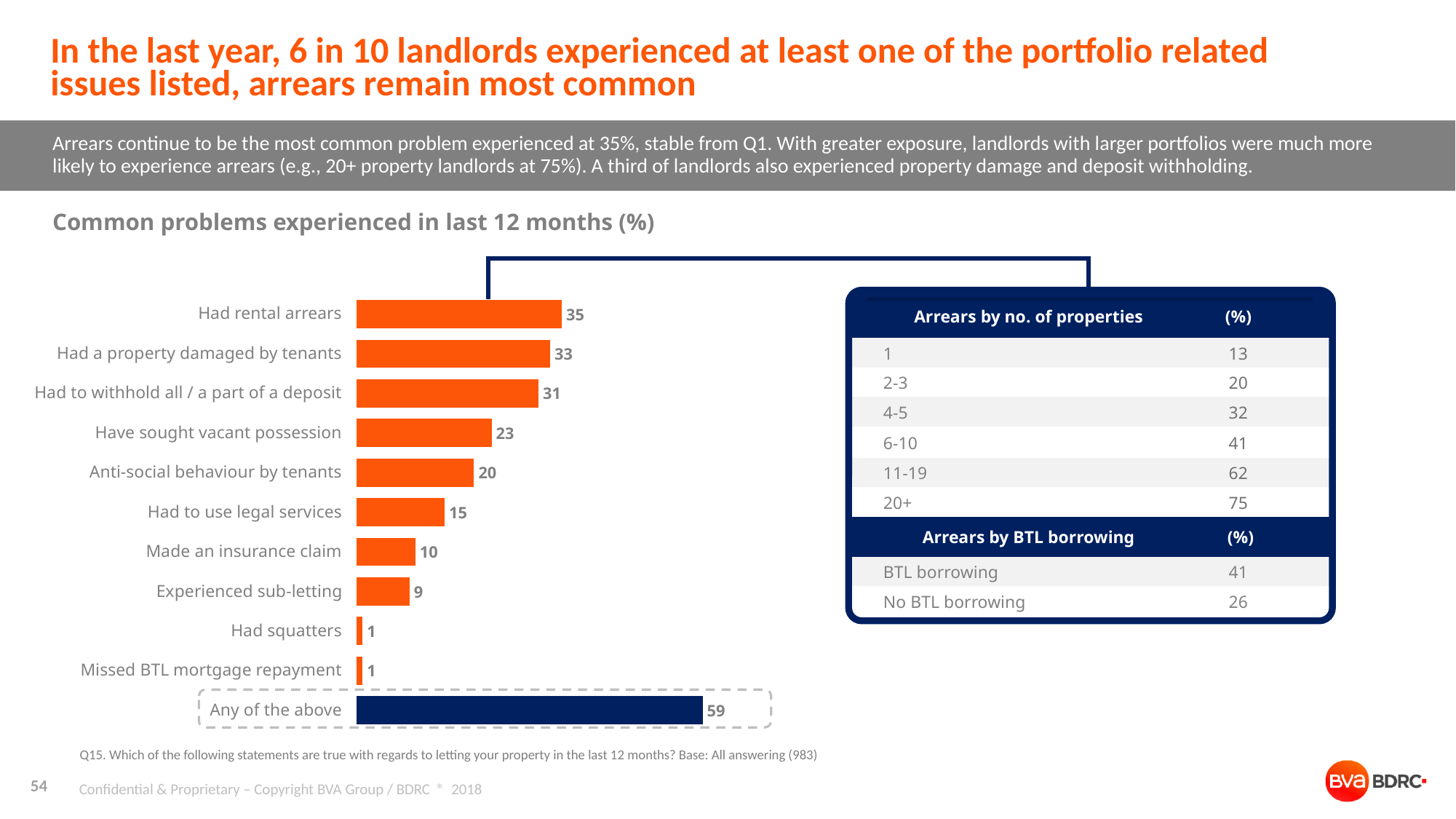
What is the value for "Have sought vacant possession"? 23 What is the difference between the values for "Had rental arrears" and "Had a property damaged by tenants"? 2 What is the value for "Had rental arrears"? 35 What is the difference between the values for "Any of the above" and "Had rental arrears"? 24 How many bars are plotted in the chart? 11 Which category has the highest value in the chart? Any of the above What is the title of the chart? Common problems experienced in last 12 months (%) Excluding "Any of the above", which individual problem has the highest value? Had rental arrears What kind of chart is shown on the slide? Bar chart What is the value for "Experienced sub-letting"? 9 Which is larger: the value for "Had to use legal services" or for "Made an insurance claim"? Had to use legal services What is the value for "Any of the above"? 59